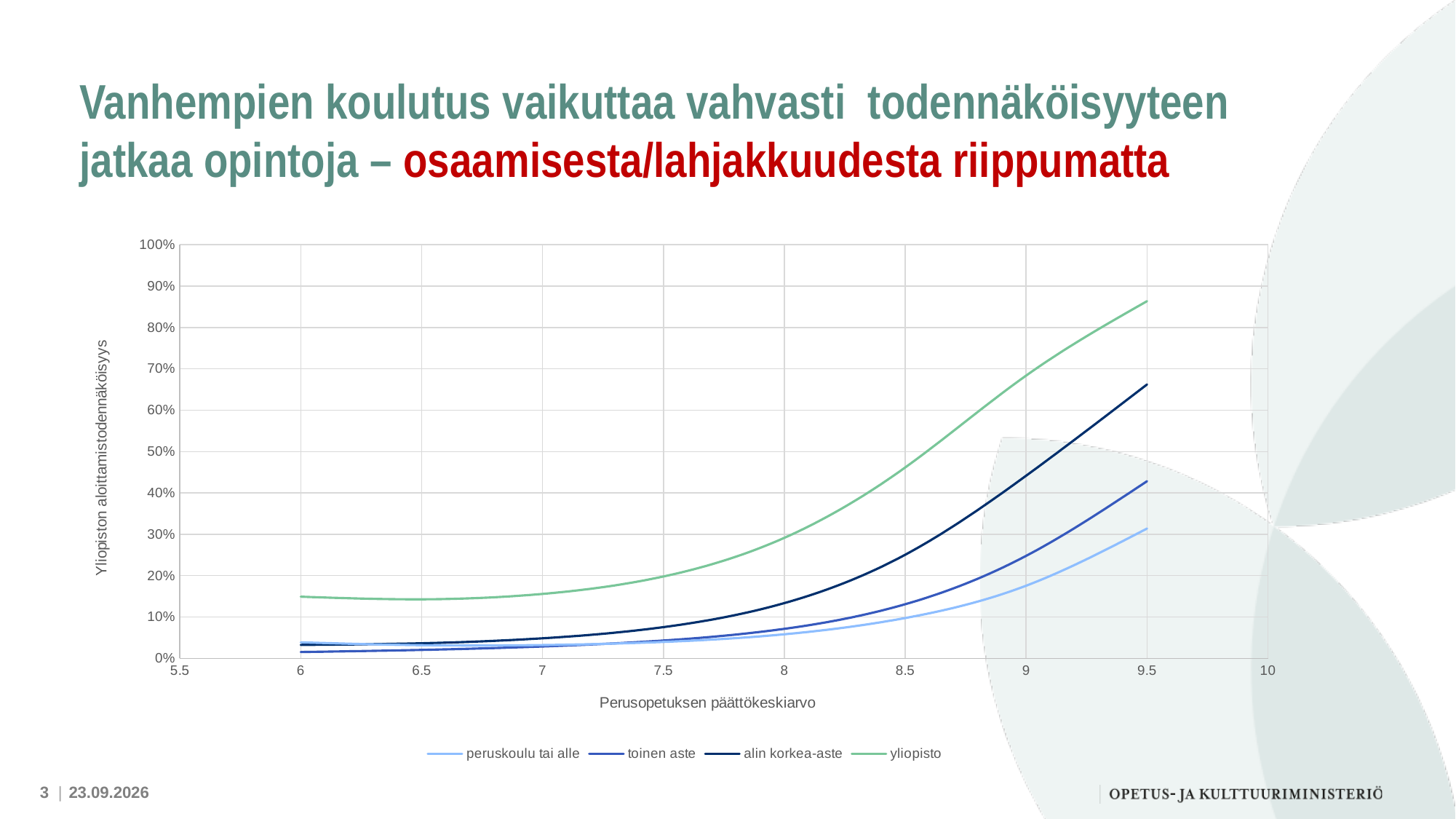
Which series has the highest value at a grade average of 9.5? yliopisto Which series has the lowest value at a grade average of 9.5? peruskoulu tai alle How many series does the legend list? 4 What kind of chart is shown on the slide? line chart Is the value for yliopisto at a grade average of 9.5 greater or less than 80%? greater Is the value for peruskoulu tai alle at a grade average of 9.5 greater or less than 40%? less Is the value for yliopisto at a grade average of 6 greater or less than 10%? greater Do the values for yliopisto rise or fall as the grade average increases from 7 to 9.5? rise At a grade average of 9, which is larger: the value for yliopisto or the value for toinen aste? yliopisto What is the title of the x axis? Perusopetuksen päättökeskiarvo